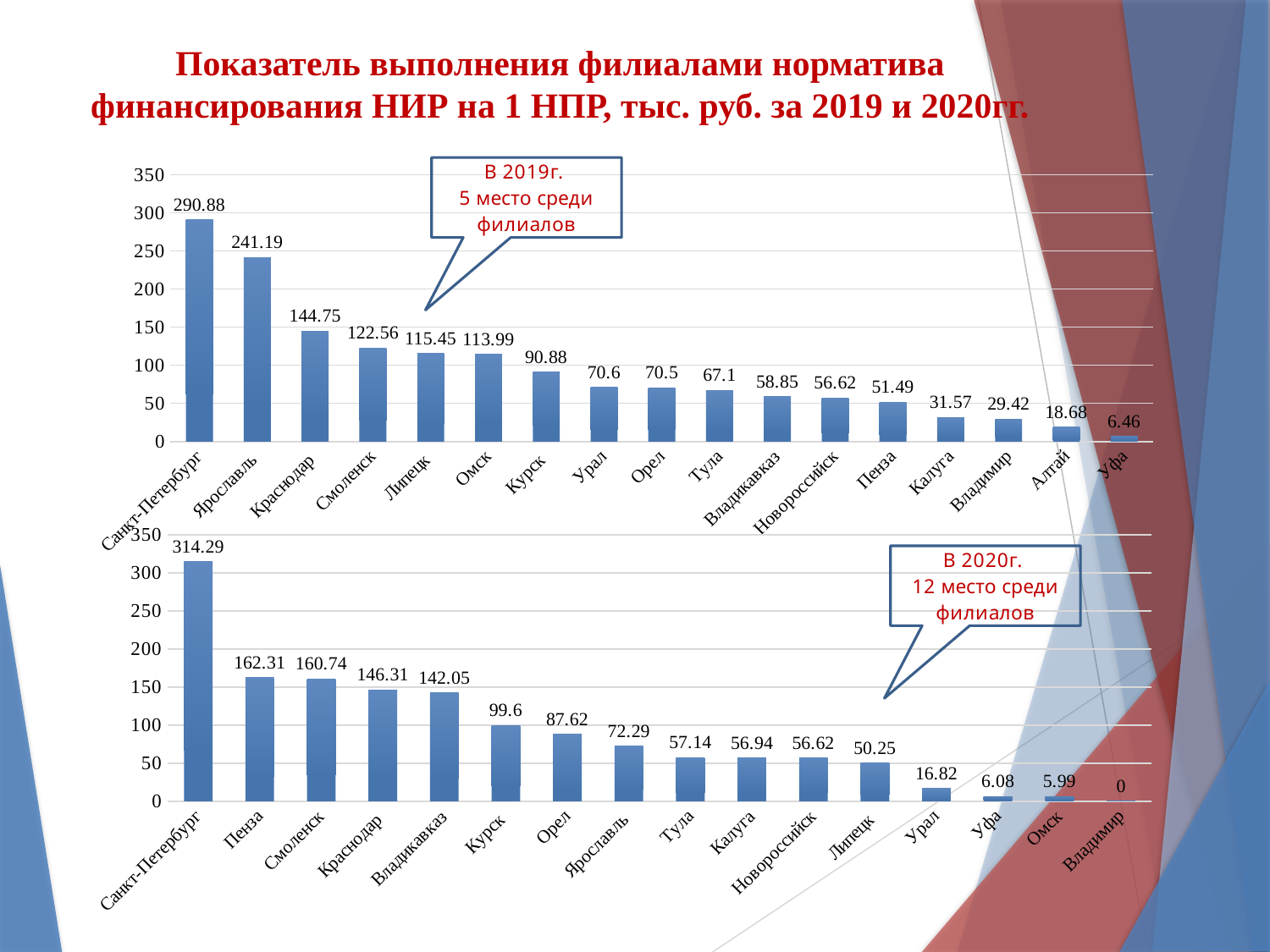
In the bottom chart (2020), do the values rise or fall from left to right? Fall In the bottom chart (2020), how many branches are shown? 16 In the top chart (2019), how many branches are shown? 17 In the bottom chart (2020), which is larger: the value for Курск or the value for Орел? Курск In the top chart (2019), which branch has the highest value? Санкт-Петербург In the bottom chart (2020), which branch has the lowest value? Владимир In the bottom chart (2020), what is the value for Санкт-Петербург? 314.29 In the top chart (2019), what is the difference between the values for Санкт-Петербург and Ярославль? 49.69 In the top chart (2019), what is the value for Уфа? 6.46 In the top chart (2019), what is the value for Ярославль? 241.19 In the bottom chart (2020), what is the value for Пенза? 162.31 What type of chart is used on this slide? Bar chart